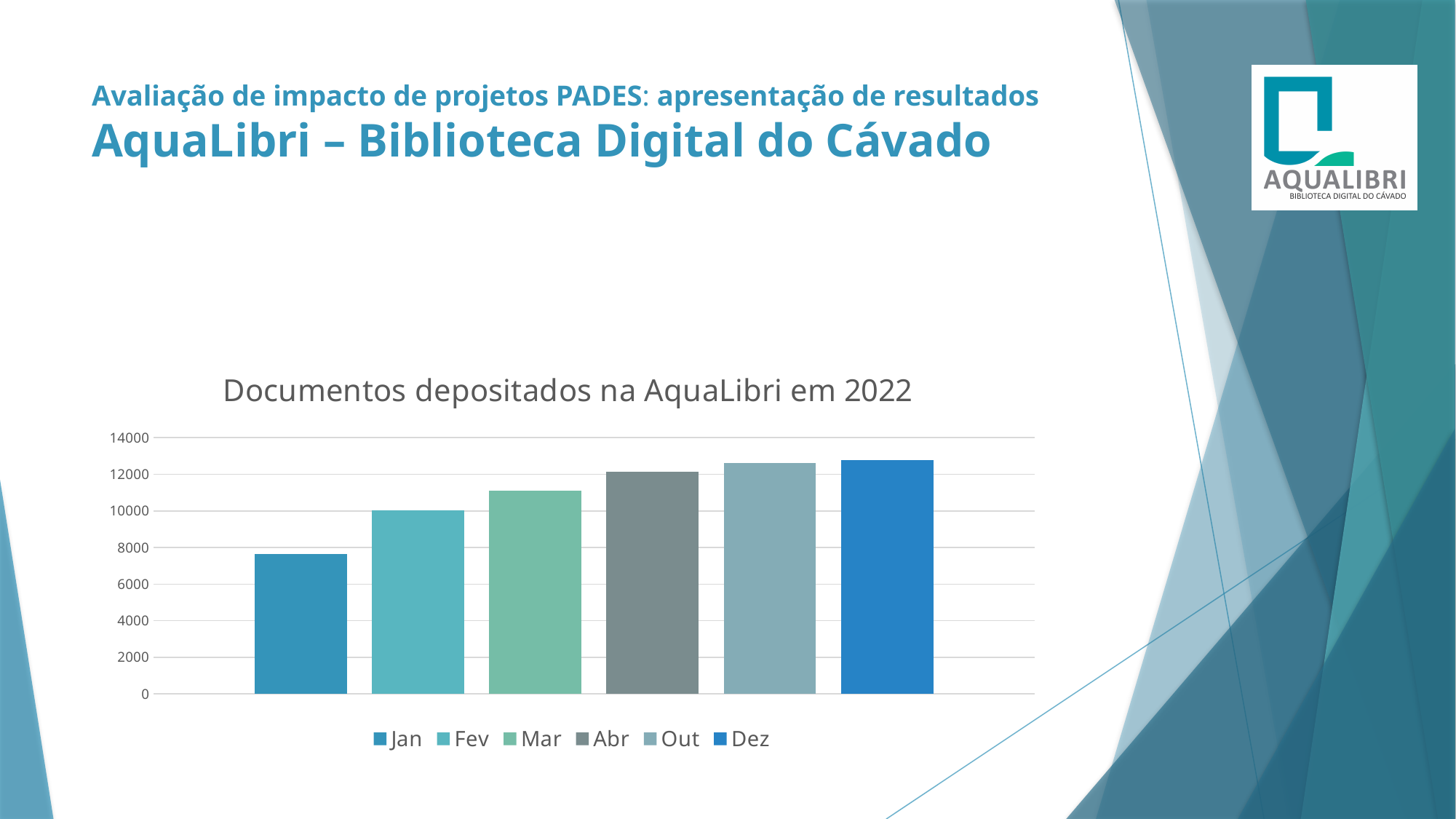
Do the values rise or fall from left to right across the chart? rise Which month has the lowest value in the chart? Jan How many entries does the chart legend list? 6 Is the value for Out greater or less than 12000? greater What kind of chart is shown on the slide? bar chart Which is larger, the value for Fev or the value for Abr? Abr What is the title of the chart? Documentos depositados na AquaLibri em 2022 Which is larger, the value for Jan or the value for Mar? Mar Is the value for Jan greater or less than 8000? less How many bars are plotted in the chart? 6 Is the value for Dez greater or less than 14000? less